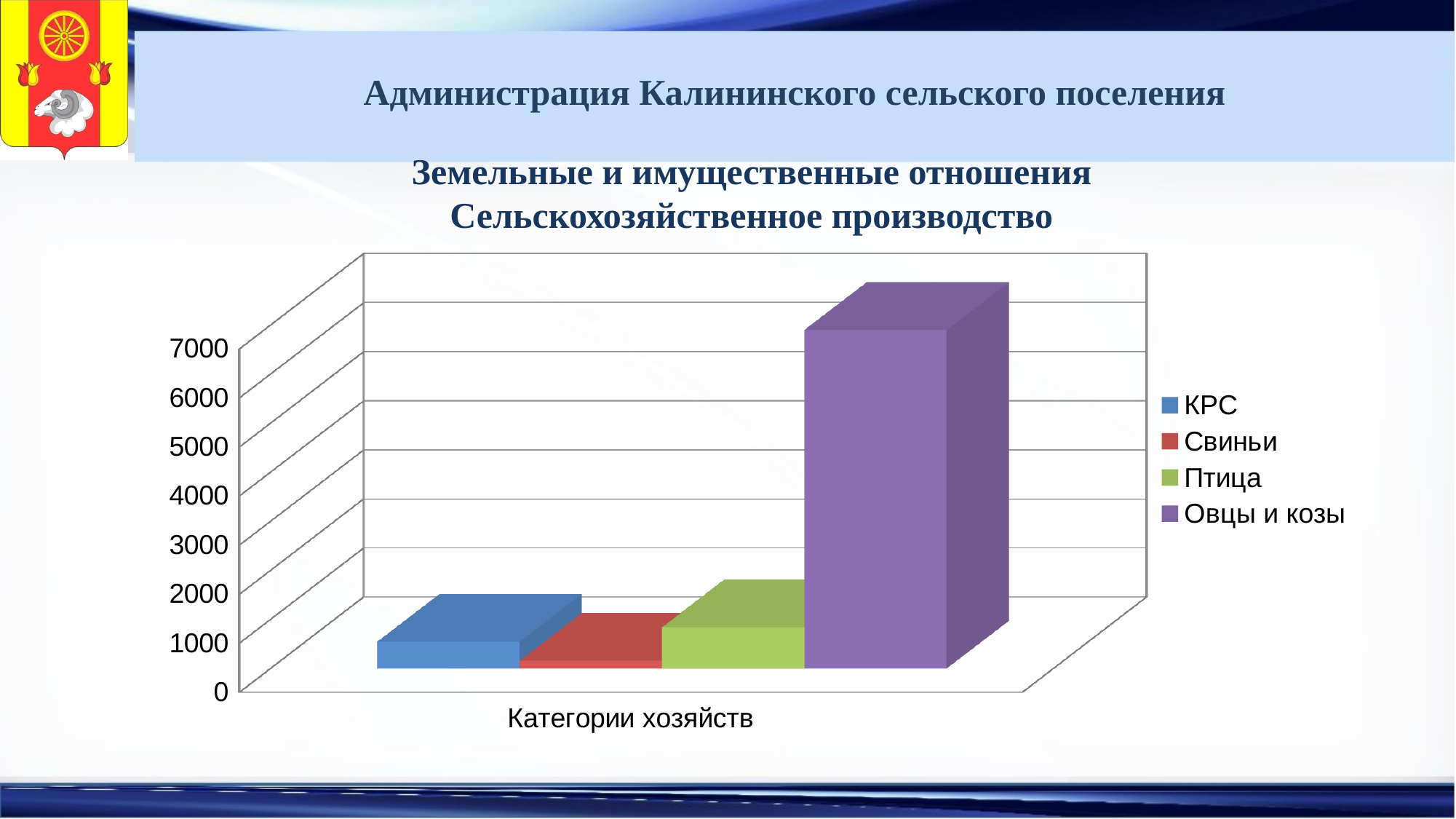
Which is larger, the value for Птица or the value for КРС? Птица Which series has the lowest value? Свиньи Is the value for Птица greater or less than 3000? less Is the value for Овцы и козы greater or less than 5000? greater Is the value for Свиньи greater or less than 1000? less What kind of chart is shown on the slide? bar chart How many categories are shown on the x axis? 1 Which series is shown in purple? Овцы и козы What is the label of the category on the x axis? Категории хозяйств Which series has the highest value? Овцы и козы How many series does the legend list? 4